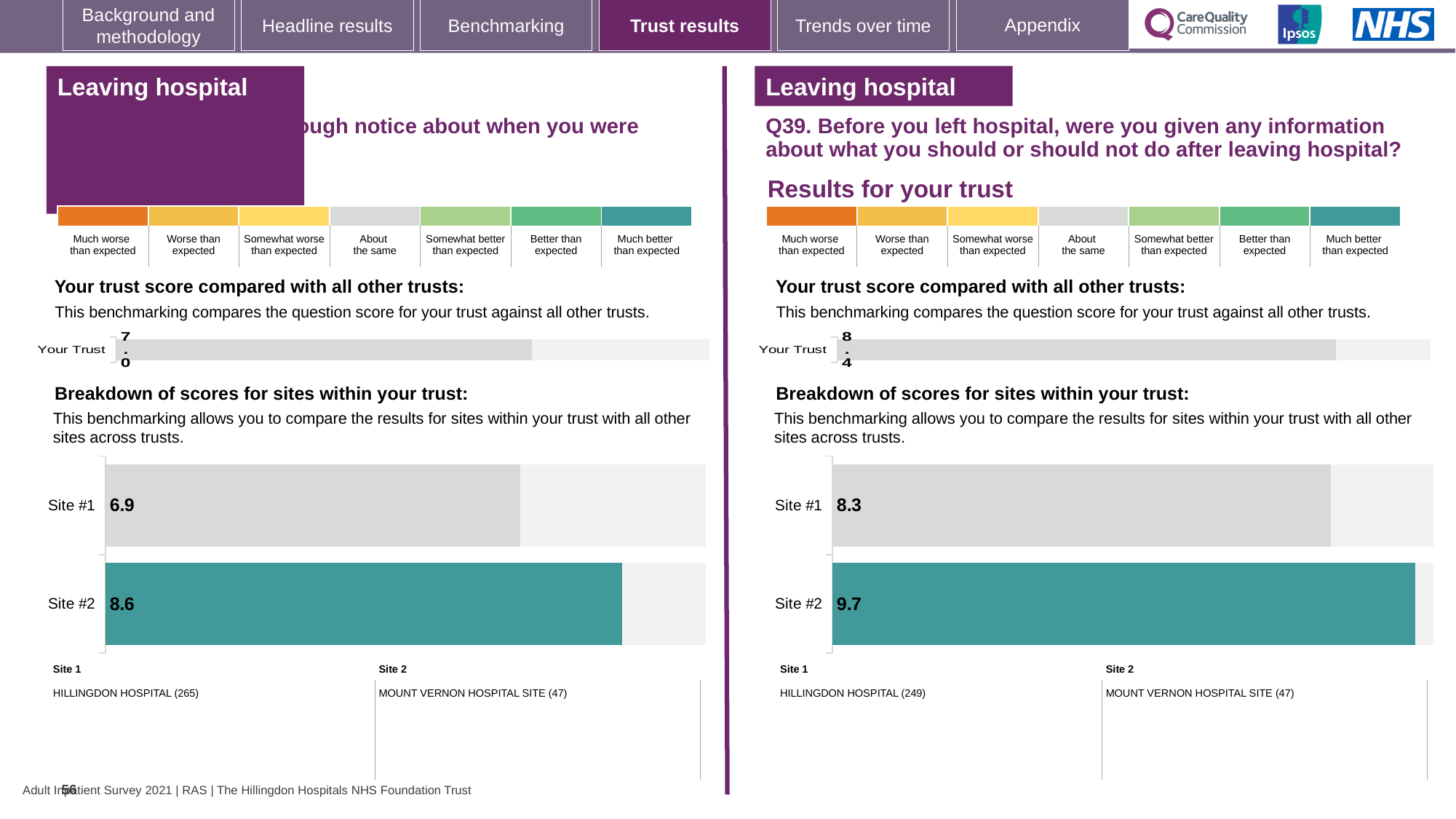
In the site breakdown chart on the right-hand side of the slide (Q39), what is the difference between the Site #2 and Site #1 scores? 1.4 In the site breakdown chart on the right-hand side of the slide (Q39), what is the score for Site #2? 9.7 In the site breakdown chart on the right-hand side of the slide (Q39), which site has the higher score? Site #2 In the 'Your Trust' chart on the left-hand side of the slide, what is the trust score? 7.0 In the site breakdown chart on the left-hand side of the slide, what is the difference between the Site #2 and Site #1 scores? 1.7 What type of chart is used for the site breakdown on the left-hand side of the slide? Bar chart In the site breakdown chart on the left-hand side of the slide, what is the score for Site #1? 6.9 In the site breakdown chart on the left-hand side of the slide, which site has the lower score? Site #1 How many sites are shown in the site breakdown chart on the right-hand side of the slide (Q39)? 2 In the site breakdown chart on the right-hand side of the slide (Q39), what is the score for Site #1? 8.3 In the site breakdown chart on the left-hand side of the slide, what is the score for Site #2? 8.6 In the 'Your Trust' chart on the right-hand side of the slide (Q39), what is the trust score? 8.4